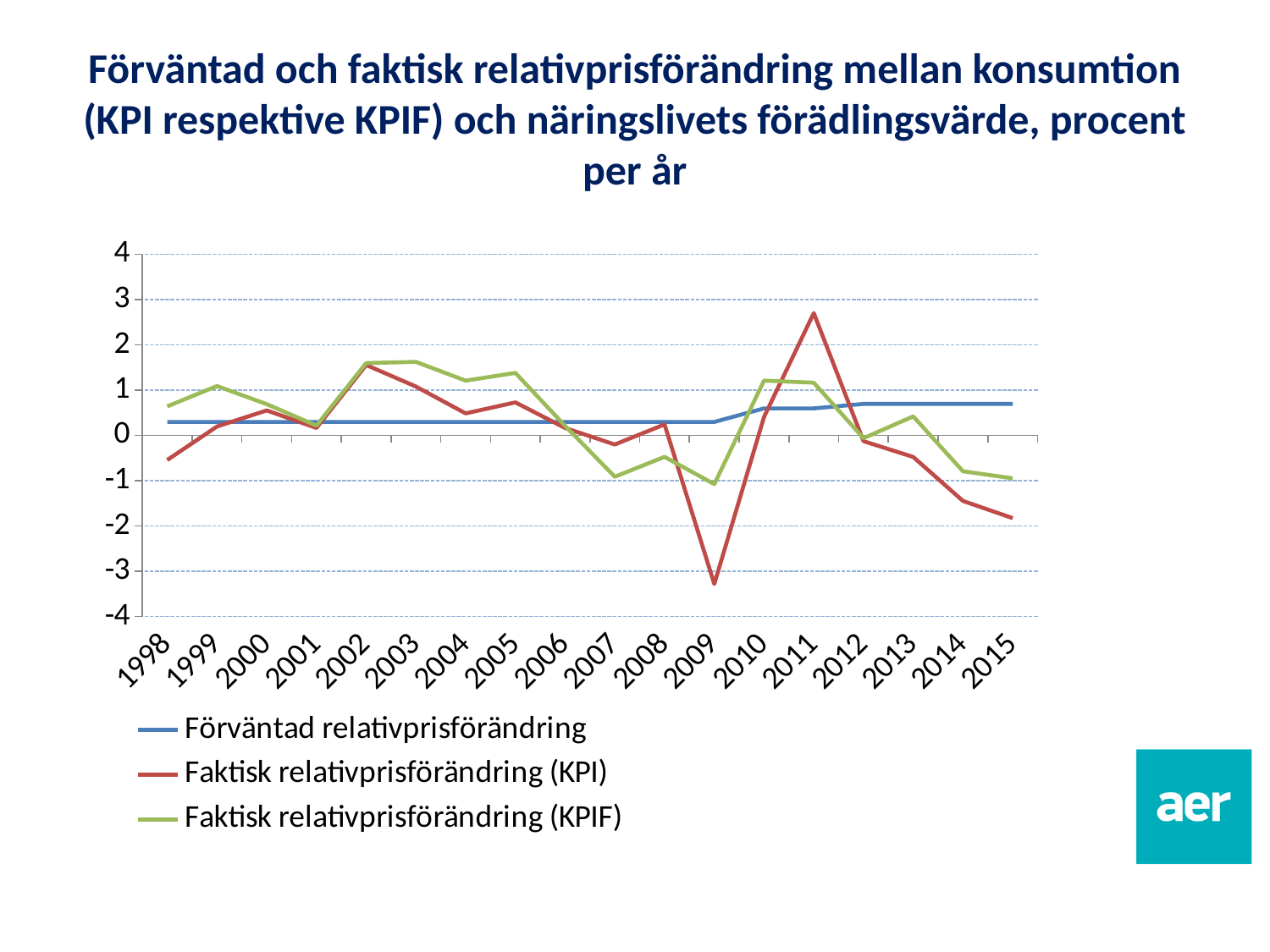
In 2011, which is larger: Faktisk relativprisförändring (KPI) or Faktisk relativprisförändring (KPIF)? Faktisk relativprisförändring (KPI) In which year is Faktisk relativprisförändring (KPI) at its highest? 2011 How many years are shown on the x axis? 18 In 2009, which is larger: Faktisk relativprisförändring (KPI) or Faktisk relativprisförändring (KPIF)? Faktisk relativprisförändring (KPIF) Is the value for Faktisk relativprisförändring (KPI) in 2009 greater or less than -3? less Is the value for Faktisk relativprisförändring (KPIF) in 2003 greater or less than 1? greater What kind of chart is shown on the slide? line chart Does Förväntad relativprisförändring rise or fall between 2008 and 2012? rise Is the value for Faktisk relativprisförändring (KPI) in 2015 greater or less than -1? less In which year is Faktisk relativprisförändring (KPI) at its lowest? 2009 How many series does the legend list? 3